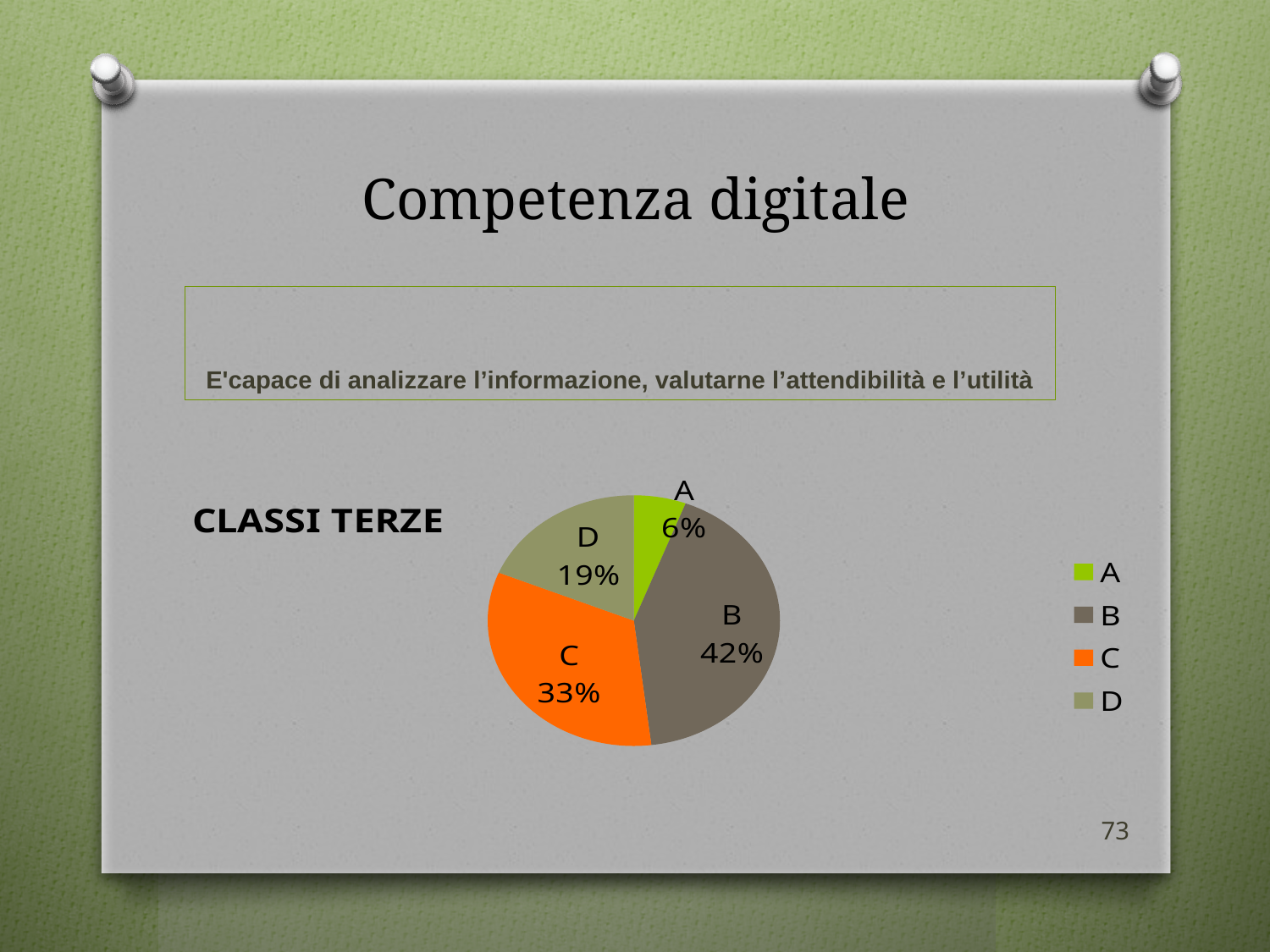
How many slices does the pie chart have? 4 Which slice is the largest in the pie chart? B What percentage of the pie does slice A represent? 6% What percentage of the pie does slice C represent? 33% Which slice is the smallest in the pie chart? A What percentage of the pie does slice B represent? 42% What percentage of the pie does slice D represent? 19% What kind of chart is shown on the slide? pie chart What colour is slice C in the pie chart? orange How many entries does the legend list? 4 Which is larger, slice C or slice D? C What is the difference in percentage points between slice B and slice C? 9